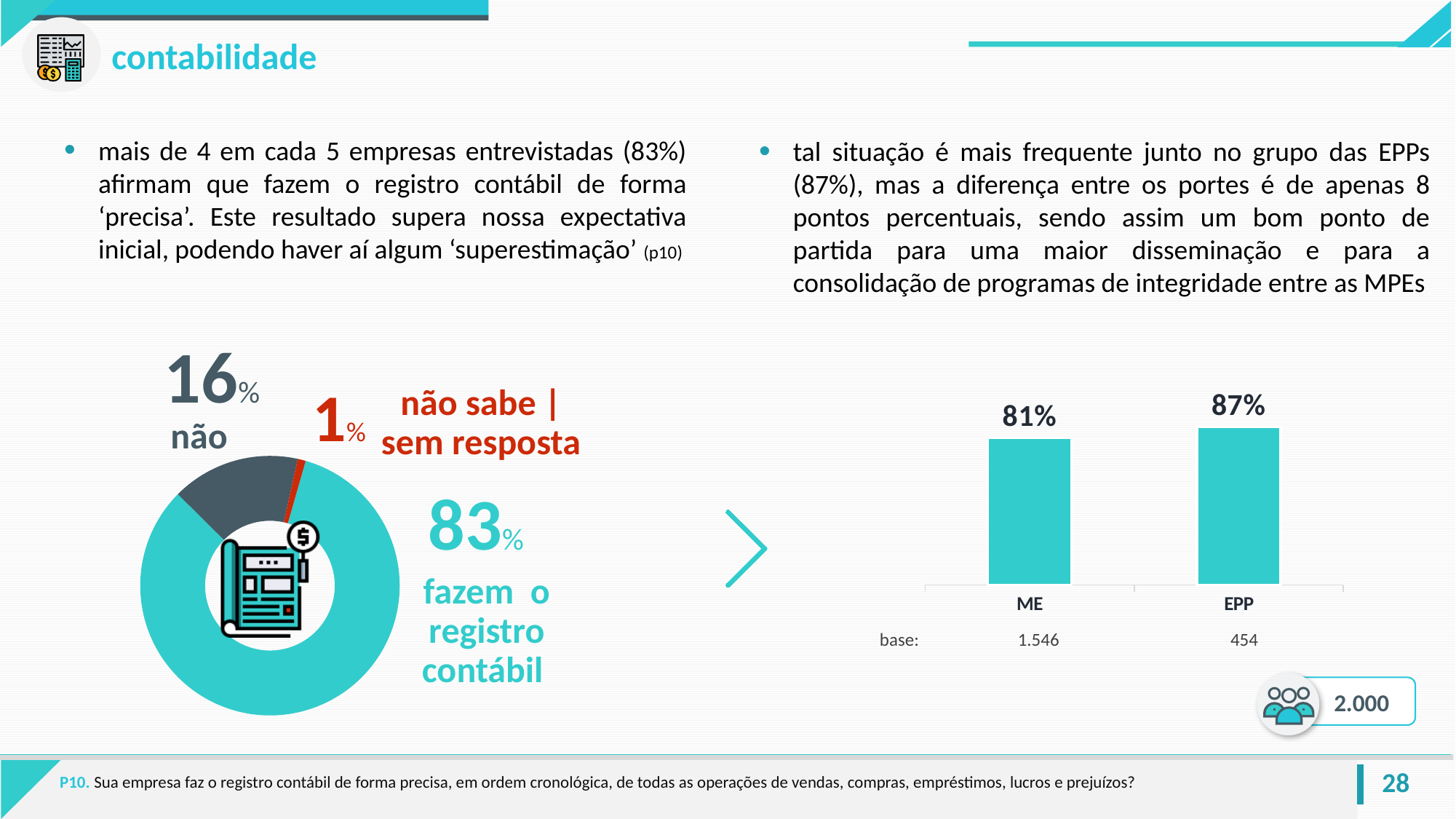
In the bar chart on the right, what is the value for ME? 81% In the donut chart on the left, which category has the smallest slice? não sabe | sem resposta In the bar chart on the right, which category has the higher value, ME or EPP? EPP In the bar chart on the right, what is the difference between the EPP and ME values? 6 percentage points What type of chart is shown on the right side of the slide? Bar chart In the bar chart on the right, what is the value for EPP? 87% In the bar chart on the right, how many bars are shown? 2 In the donut chart on the left, how many slices are there? 3 In the donut chart on the left, what share of companies say they do the accounting record ('fazem o registro contábil')? 83% In the donut chart on the left, what share corresponds to 'não sabe | sem resposta'? 1% In the donut chart on the left, what share of companies answered 'não'? 16% In the donut chart on the left, which category has the largest slice? fazem o registro contábil